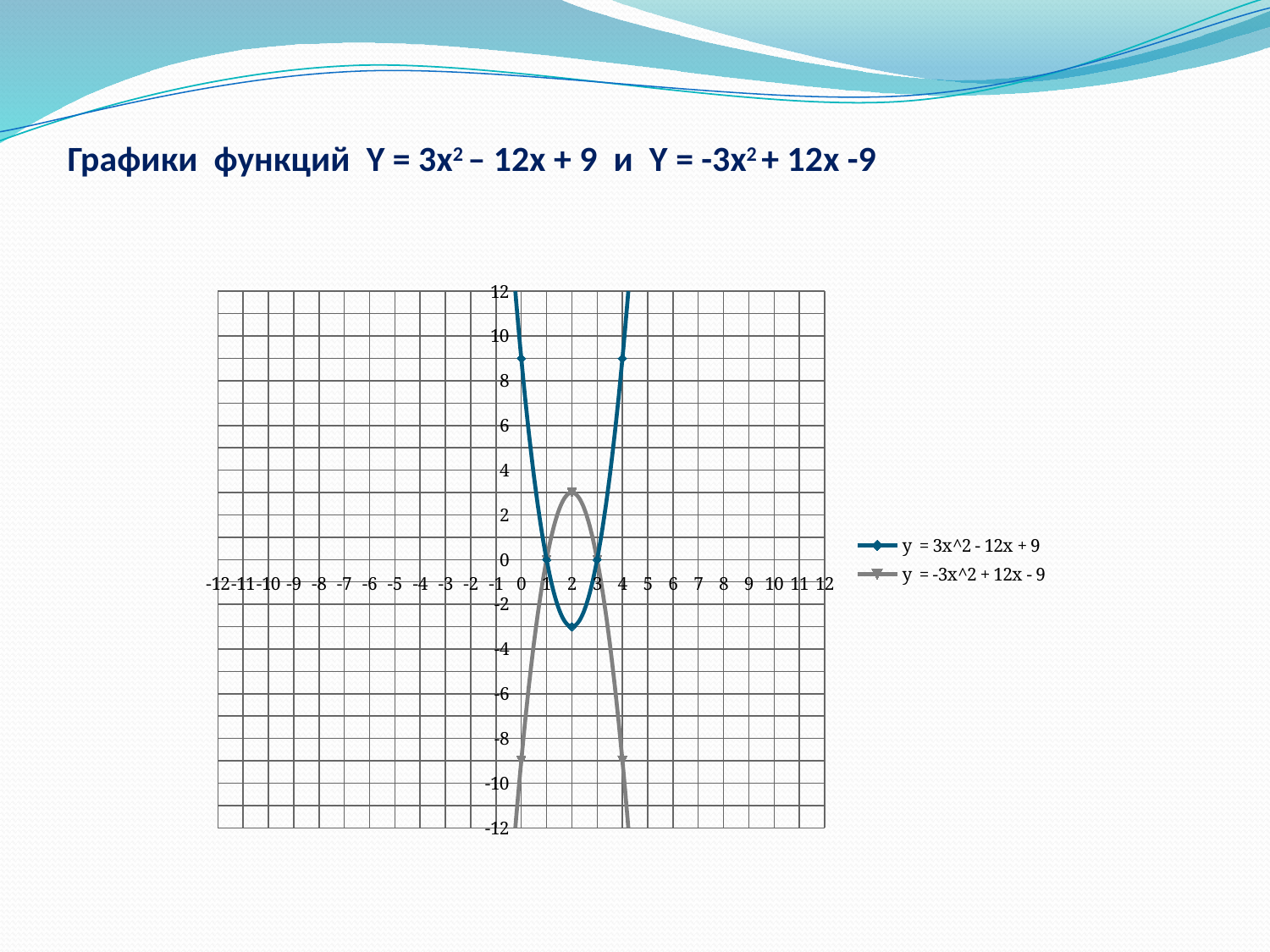
Is the value of the series y = 3x^2 - 12x + 9 at x = 2 greater or less than -2? less Is the value of the series y = 3x^2 - 12x + 9 at x = 0 greater or less than 8? greater At which x value does the series y = 3x^2 - 12x + 9 reach its lowest point? 2 What kind of chart is shown on the slide? line chart Is the value of the series y = -3x^2 + 12x - 9 at x = 4 greater or less than -8? less Does the series y = -3x^2 + 12x - 9 rise or fall as x goes from 2 to 4? fall How many series does the legend list? 2 What is the value of the series y = 3x^2 - 12x + 9 at x = 1? 0 At x = 2, which series has the higher value? y = -3x^2 + 12x - 9 What is the value of the series y = -3x^2 + 12x - 9 at x = 1? 0 What is the value of the series y = 3x^2 - 12x + 9 at x = 3? 0